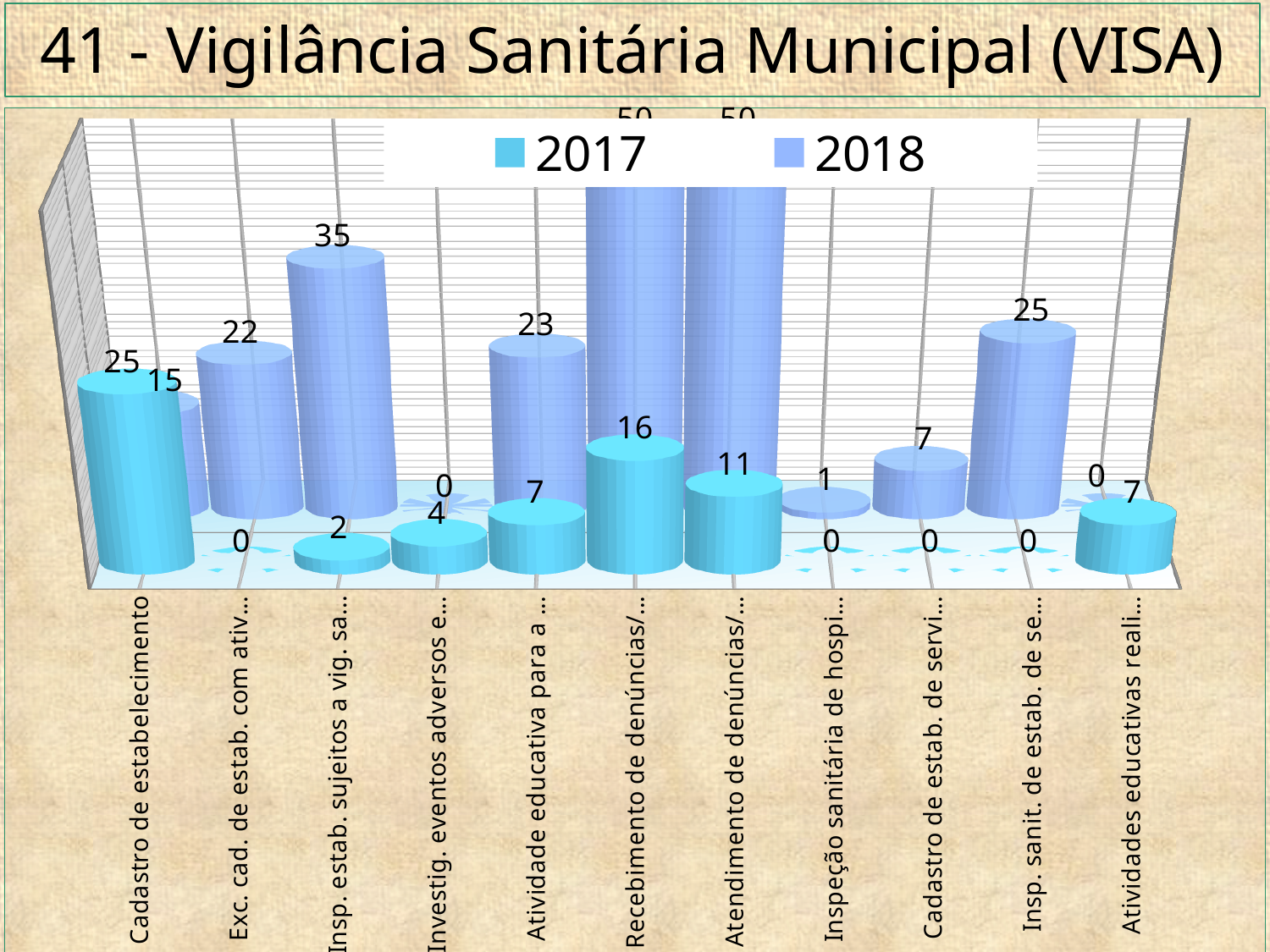
What is the 2018 value for the category beginning "Insp. estab. sujeitos a vig. sa..."? 35 What is the 2018 value for the category beginning "Cadastro de estab. de servi..."? 7 How many categories are shown on the x axis? 11 Which series is shown in the lighter cyan colour? 2017 Which category has the highest 2017 value? Cadastro de estabelecimento What is the difference between the 2018 and 2017 values for the category beginning "Atividade educativa para a ..."? 16 For the category beginning "Atendimento de denúncias/...", which series has the larger value, 2017 or 2018? 2018 What is the 2017 value for "Cadastro de estabelecimento"? 25 What is the 2017 value for the category beginning "Recebimento de denúncias/..."? 16 What is the 2018 value for "Cadastro de estabelecimento"? 15 What kind of chart is shown on the slide? bar chart How many series does the legend list? 2